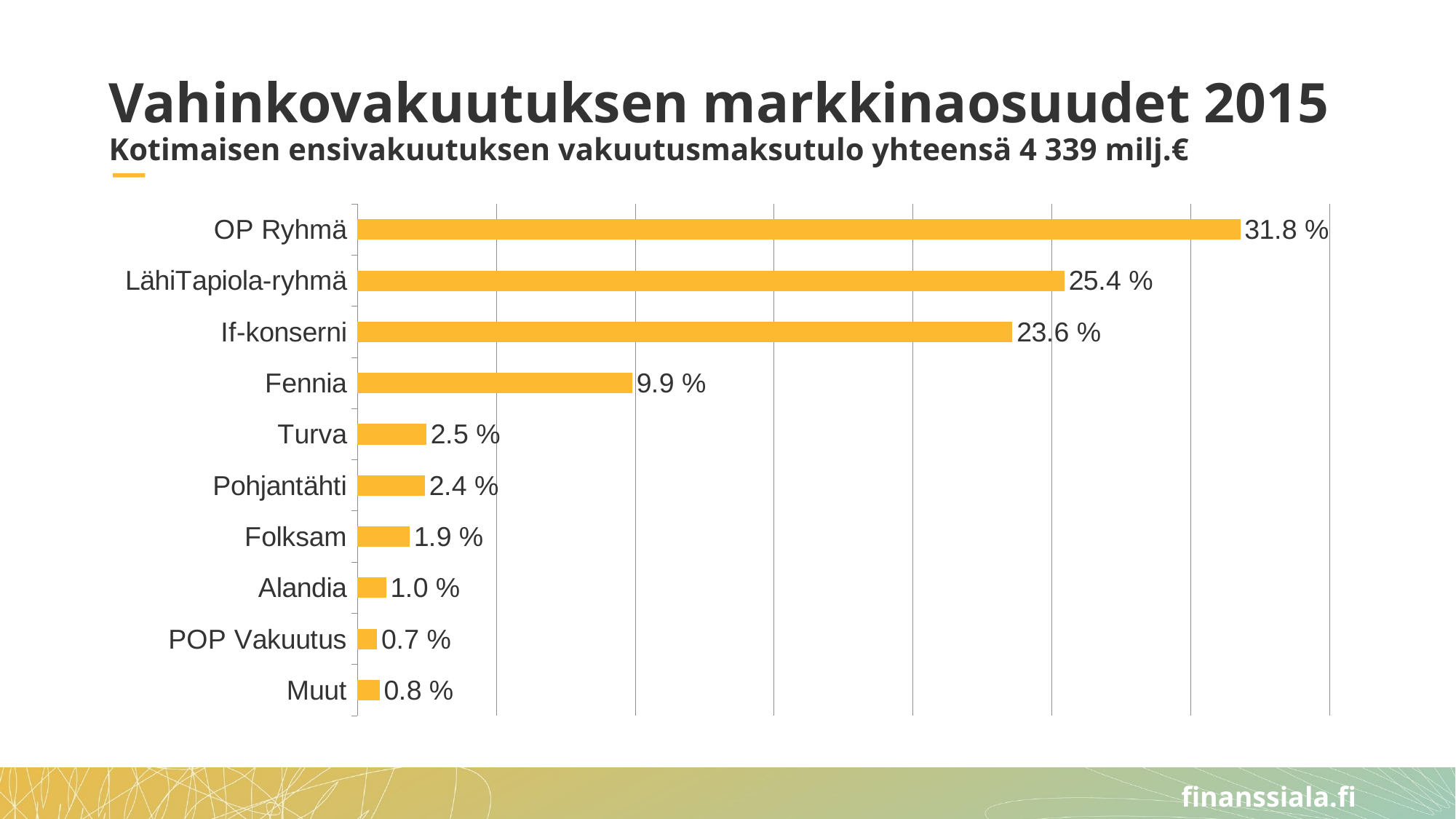
What is the market share shown for OP Ryhmä? 31.8 % What is the market share shown for POP Vakuutus? 0.7 % Which company has the highest market share on the chart? OP Ryhmä What is the difference in market share between If-konserni and Fennia? 13.7 % What is the difference in market share between OP Ryhmä and LähiTapiola-ryhmä? 6.4 % Which has a larger market share, LähiTapiola-ryhmä or If-konserni? LähiTapiola-ryhmä How many categories are shown on the chart? 10 What is the title of the slide? Vahinkovakuutuksen markkinaosuudet 2015 What is the market share shown for Folksam? 1.9 % What kind of chart is shown on the slide? Bar chart What is the market share shown for Fennia? 9.9 % Which category has the lowest market share on the chart? POP Vakuutus